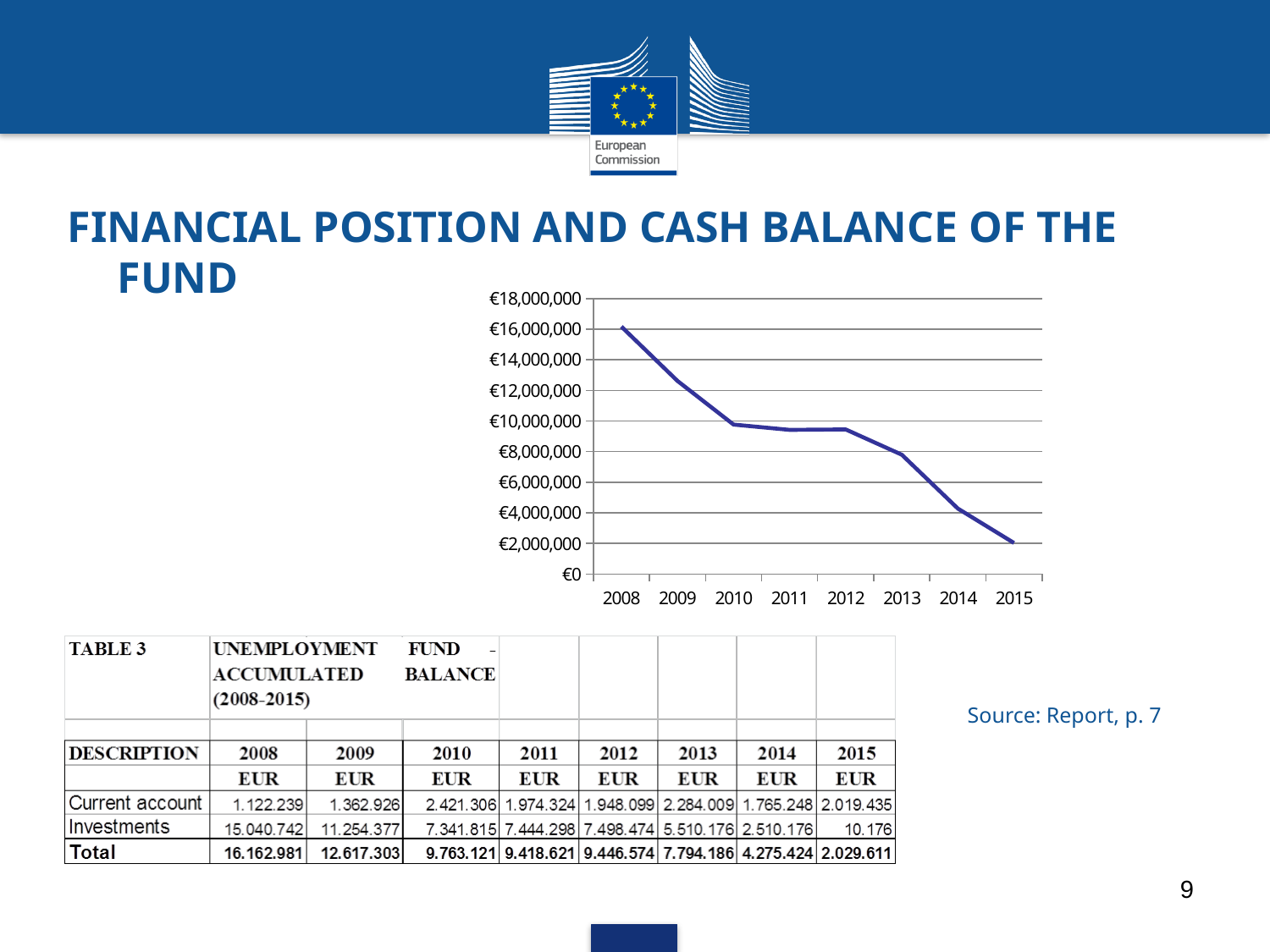
What kind of chart is shown on the slide? line chart What is the highest tick label shown on the y axis of the chart? €18,000,000 Is the value for 2014 greater or less than €6,000,000? less Do the values on the chart rise or fall from 2008 to 2015? fall How many years are plotted on the x axis of the chart? 8 Is the value for 2010 greater or less than €8,000,000? greater Which year has the lowest value on the chart? 2015 Is the value for 2009 greater or less than €12,000,000? greater Which is larger on the chart, the value for 2009 or the value for 2012? 2009 Which year has the highest value on the chart? 2008